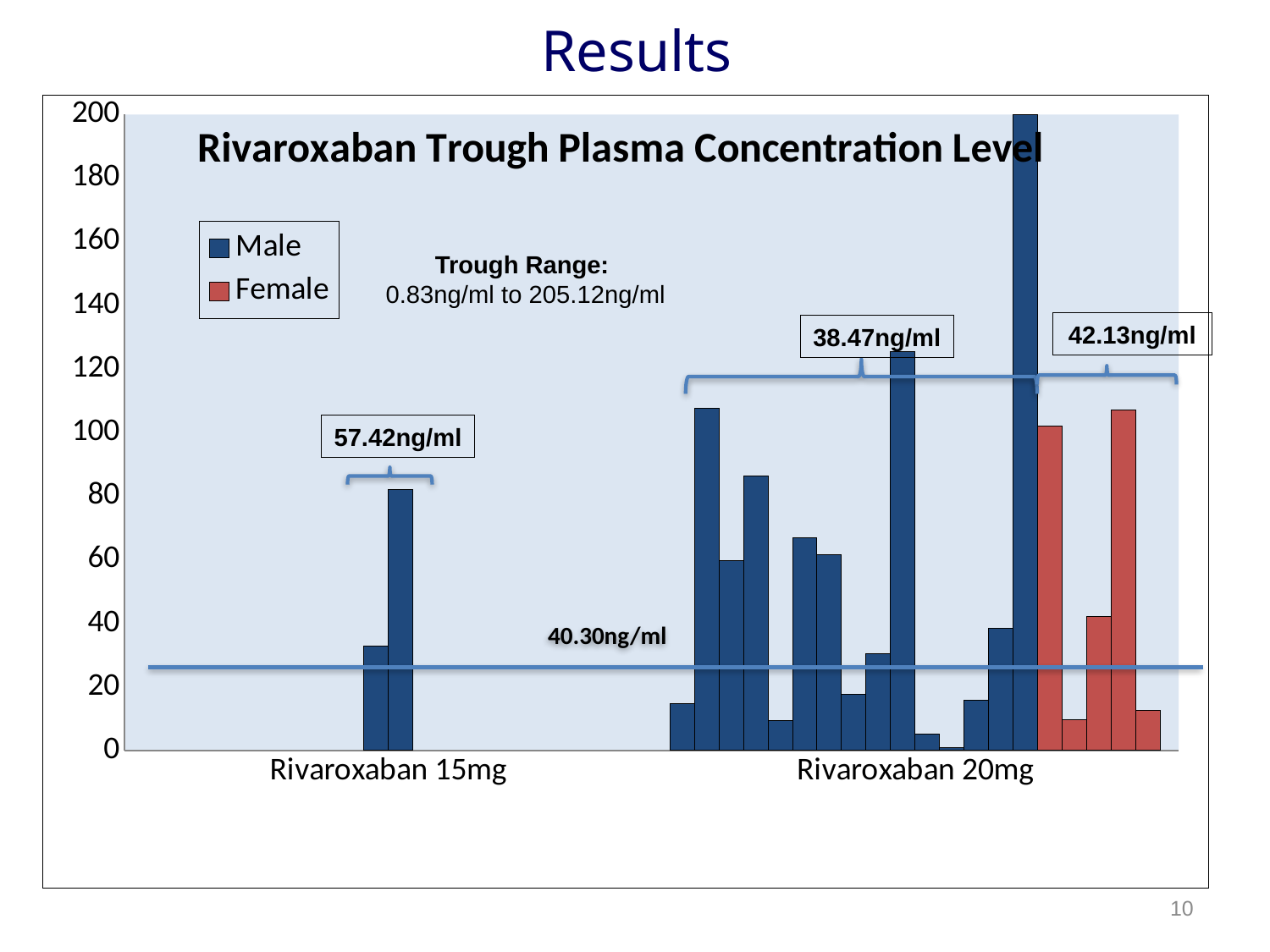
What is the difference between the female bracket value (42.13ng/ml) and the male bracket value (38.47ng/ml) for Rivaroxaban 20mg? 3.66ng/ml How many bars are plotted for Rivaroxaban 15mg? 2 What kind of chart is shown on the slide? bar chart What value is labelled above the bracket over the male bars for Rivaroxaban 20mg? 38.47ng/ml What trough range is stated on the chart? 0.83ng/ml to 205.12ng/ml What value is labelled on the horizontal line across the chart? 40.30ng/ml What value is labelled above the bracket over the Rivaroxaban 15mg bars? 57.42ng/ml What is the title of the chart? Rivaroxaban Trough Plasma Concentration Level Which labelled value for Rivaroxaban 20mg is larger, the male bracket value or the female bracket value? the female bracket value (42.13ng/ml) How many dose categories are shown on the x axis? 2 How many series does the legend list? 2 Which colour represents Female in the chart? red